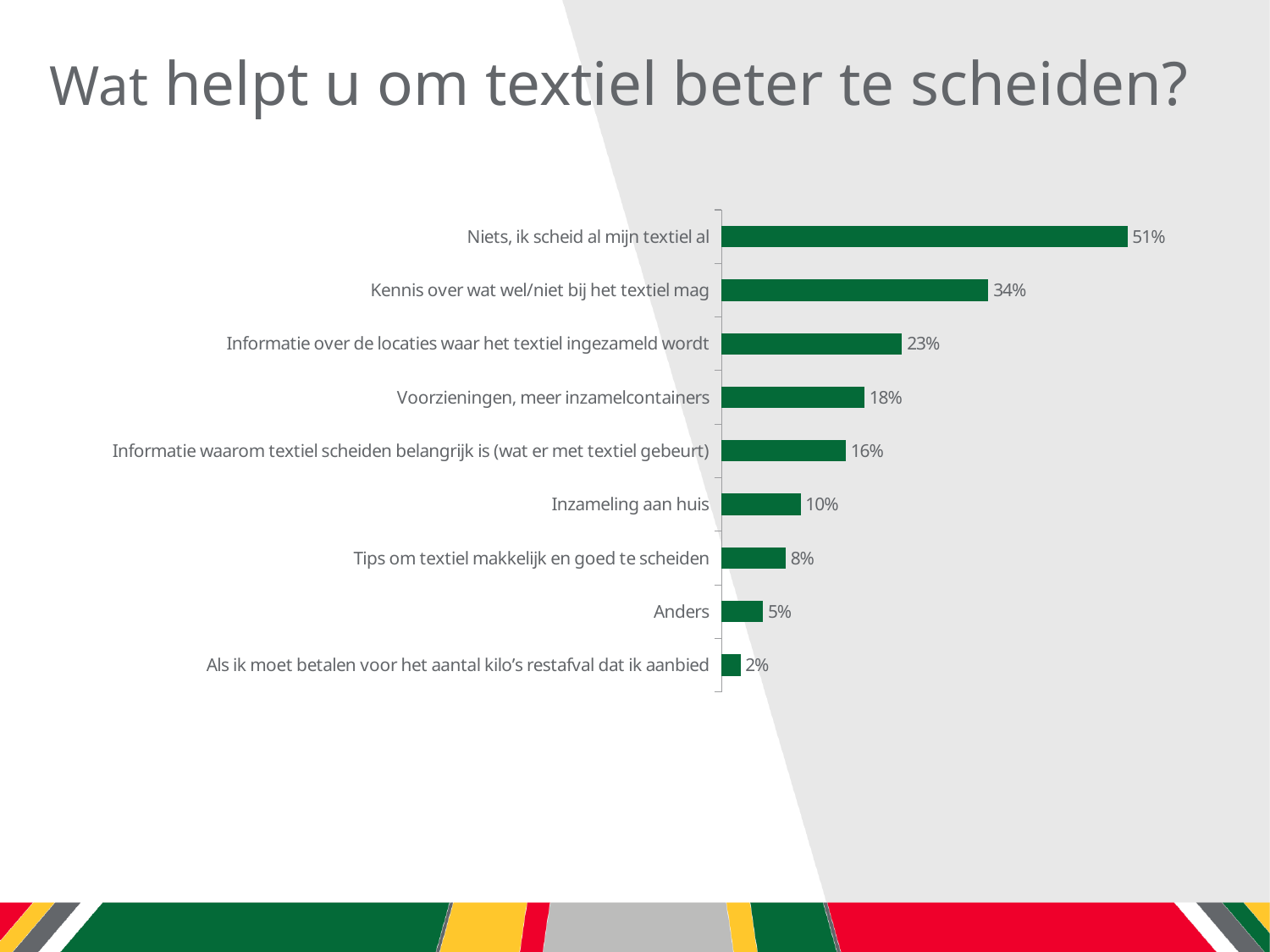
What is the difference between 'Informatie over de locaties waar het textiel ingezameld wordt' and 'Voorzieningen, meer inzamelcontainers'? 5% What is the title of the slide? Wat helpt u om textiel beter te scheiden? What is the value for 'Kennis over wat wel/niet bij het textiel mag'? 34% What type of chart is shown on the slide? Bar chart Which category has the lowest value? Als ik moet betalen voor het aantal kilo's restafval dat ik aanbied What is the difference between 'Niets, ik scheid al mijn textiel al' and 'Kennis over wat wel/niet bij het textiel mag'? 17% What percentage is shown for 'Inzameling aan huis'? 10% Which category has the highest value? Niets, ik scheid al mijn textiel al What percentage is shown for 'Niets, ik scheid al mijn textiel al'? 51% How many categories are shown in the chart? 9 What is the value for 'Voorzieningen, meer inzamelcontainers'? 18% Which is larger: 'Tips om textiel makkelijk en goed te scheiden' or 'Anders'? Tips om textiel makkelijk en goed te scheiden